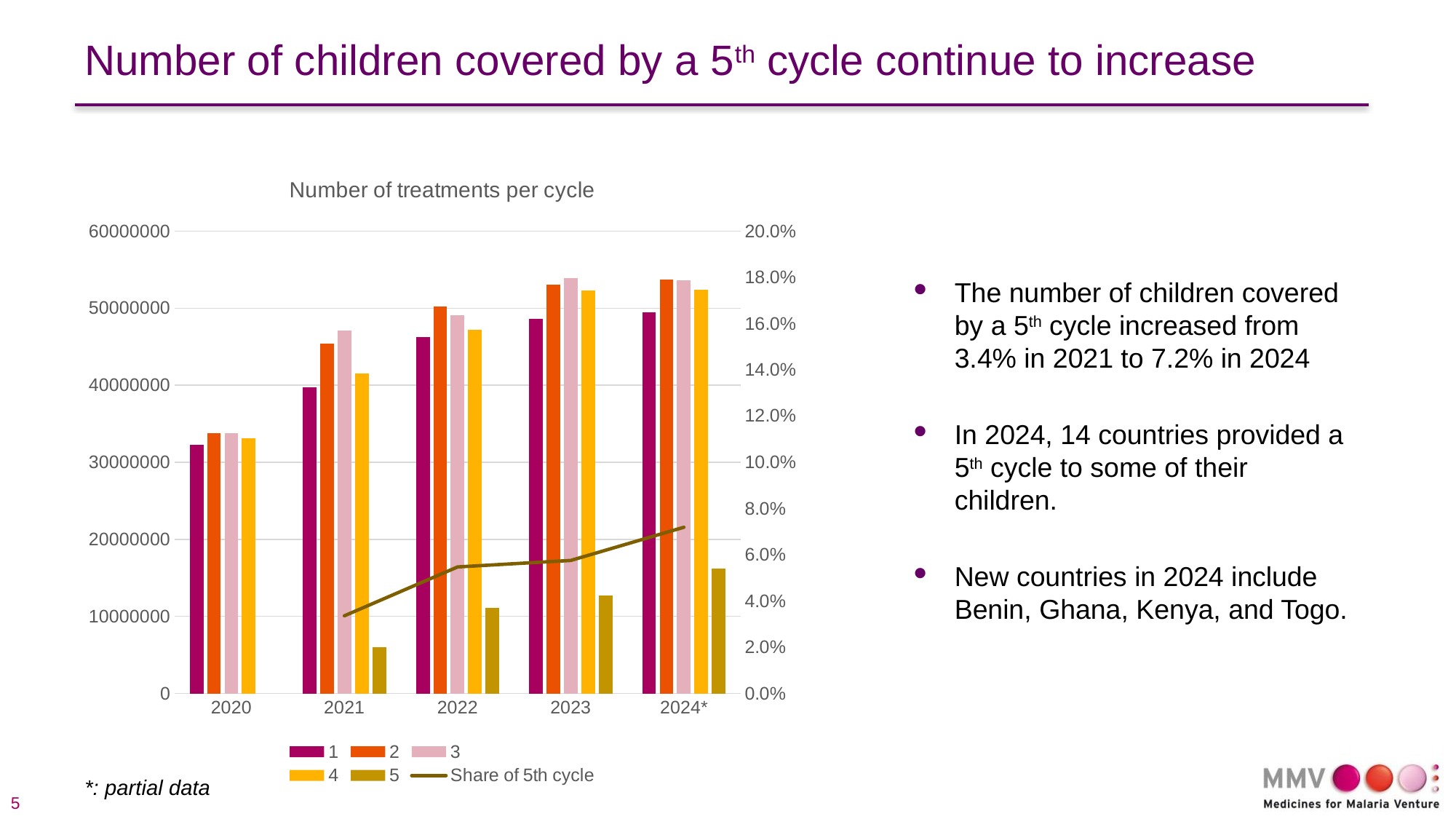
Is the value for cycle 5 in 2024* greater or less than 10000000? greater What is the name of the line series in the chart legend? Share of 5th cycle What kind of chart is shown on the slide? Bar chart with a line What is the title of the chart? Number of treatments per cycle Which year has the lowest bar for cycle 1? 2020 How many years are shown on the x axis of the chart? 5 Which cycle has the lowest bar in 2021? 5 Which is larger, the cycle 5 bar in 2022 or the cycle 5 bar in 2023? 2023 Is the value for cycle 1 in 2020 greater or less than 30000000? greater Is the value for cycle 5 in 2021 greater or less than 10000000? less How many series does the chart legend list? 6 Does the Share of 5th cycle line rise or fall from 2021 to 2024*? Rise